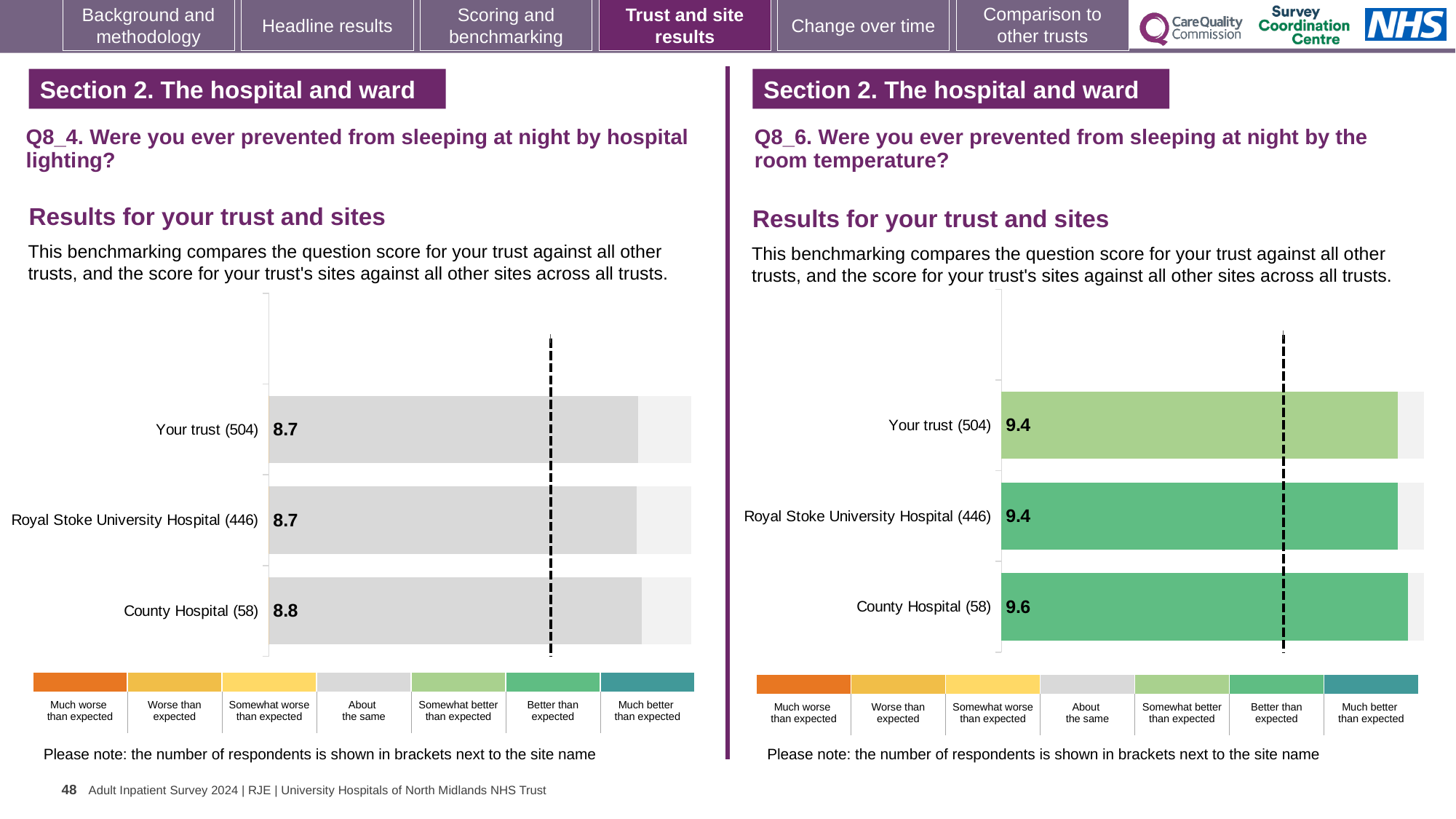
In the Q8_4 chart (hospital lighting), what is the score for County Hospital (58)? 8.8 In the Q8_4 chart (hospital lighting), what is the difference between the County Hospital (58) score and the Royal Stoke University Hospital (446) score? 0.1 In the Q8_6 chart (room temperature), what is the difference between the County Hospital (58) score and the Your trust (504) score? 0.2 In the Q8_6 chart (room temperature), which benchmark category does the colour of the Your trust (504) bar indicate? Somewhat better than expected In the Q8_4 chart (hospital lighting), what is the score for Your trust (504)? 8.7 In the Q8_4 chart (hospital lighting), which benchmark category does the colour of the bars indicate? About the same In the Q8_6 chart (room temperature), what is the score for County Hospital (58)? 9.6 In the Q8_6 chart (room temperature), which site or trust has the highest score? County Hospital (58) What type of chart is used on the left-hand side for Q8_4 (hospital lighting)? Bar chart In the Q8_6 chart (room temperature), what is the score for Royal Stoke University Hospital (446)? 9.4 How many bars are plotted in the Q8_6 chart (room temperature)? 3 In the Q8_4 chart (hospital lighting), which site or trust has the highest score? County Hospital (58)